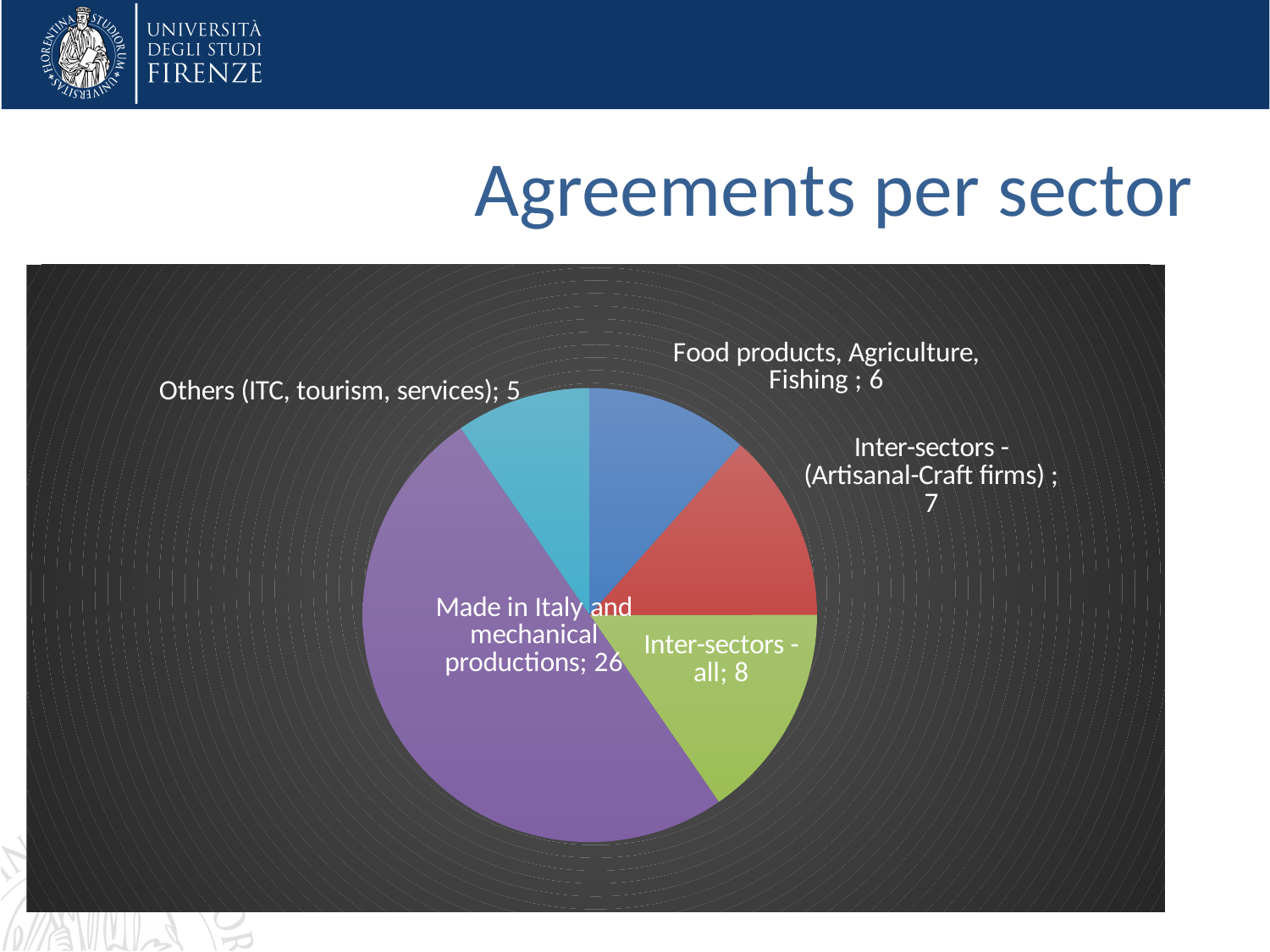
What is the value for Made in Italy and mechanical productions? 26 What is the value for Others (ITC, tourism, services)? 5 How many slices does the pie chart have? 5 Which is larger: Inter-sectors - (Artisanal-Craft firms) or Food products, Agriculture, Fishing? Inter-sectors - (Artisanal-Craft firms) What is the difference between the values for Made in Italy and mechanical productions and Inter-sectors - all? 18 What is the value for Food products, Agriculture, Fishing? 6 What is the title of the slide's chart? Agreements per sector What share of the pie does Made in Italy and mechanical productions represent? 50% Which sector has the smallest slice of the pie? Others (ITC, tourism, services) Which sector has the largest slice of the pie? Made in Italy and mechanical productions What type of chart is shown on the slide? pie chart What is the value for Inter-sectors - all? 8